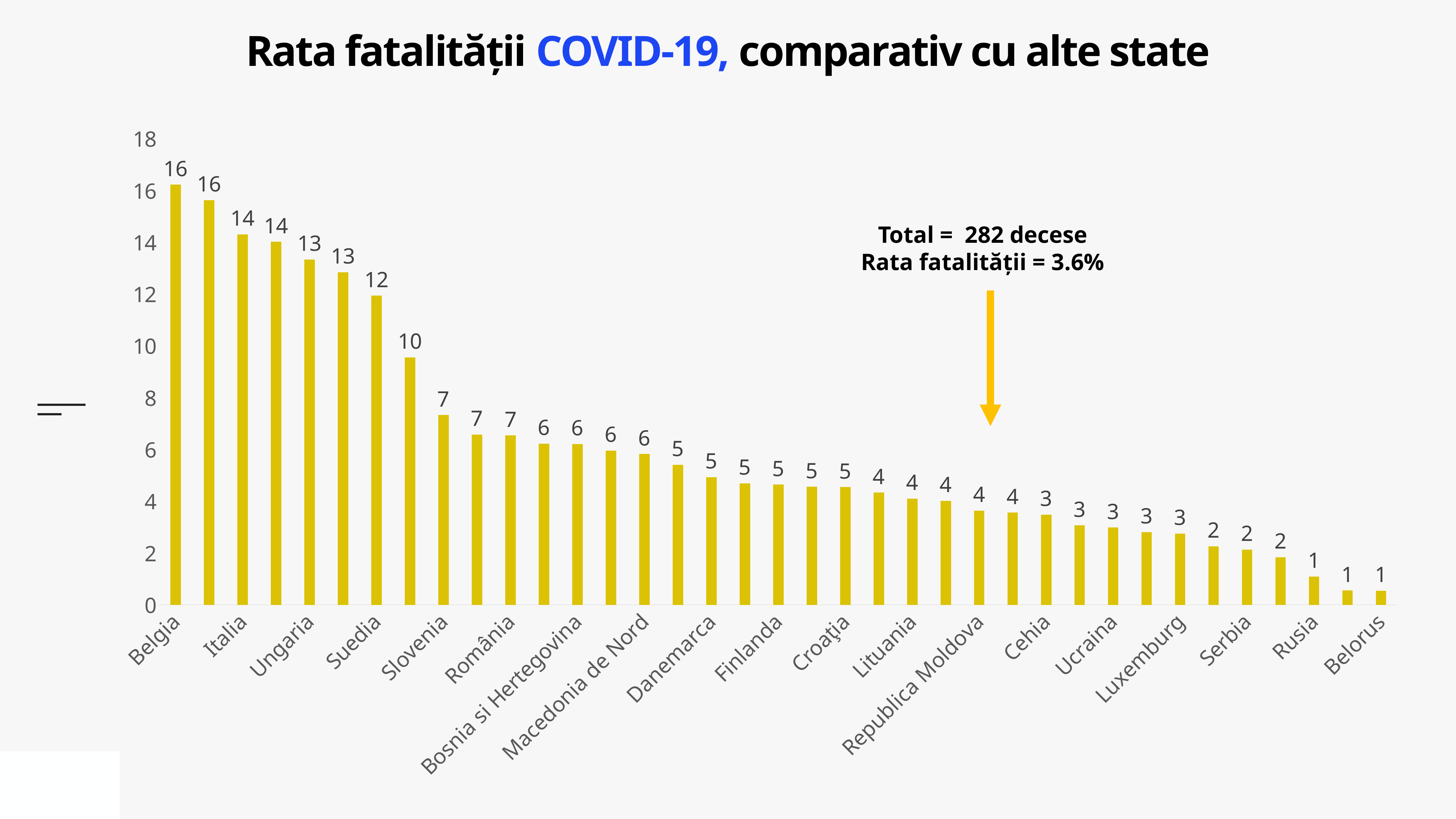
According to the annotation on the chart, what is the fatality rate (Rata fatalității) for Republica Moldova? 3.6% What is the difference between the values for Belgia and Belorus? 15 What is the value shown for Belorus? 1 What is the value shown for Republica Moldova? 4 What is the value shown for Suedia? 12 What is the value shown for Belgia? 16 What is the value shown for Italia? 14 Do the values rise or fall moving from left to right along the x axis? fall Which is larger, the value for Belgia or the value for Cehia? Belgia Which country has the highest fatality rate in the chart? Belgia According to the annotation on the chart, what is the total number of deaths (decese)? 282 What type of chart is shown on the slide? bar chart